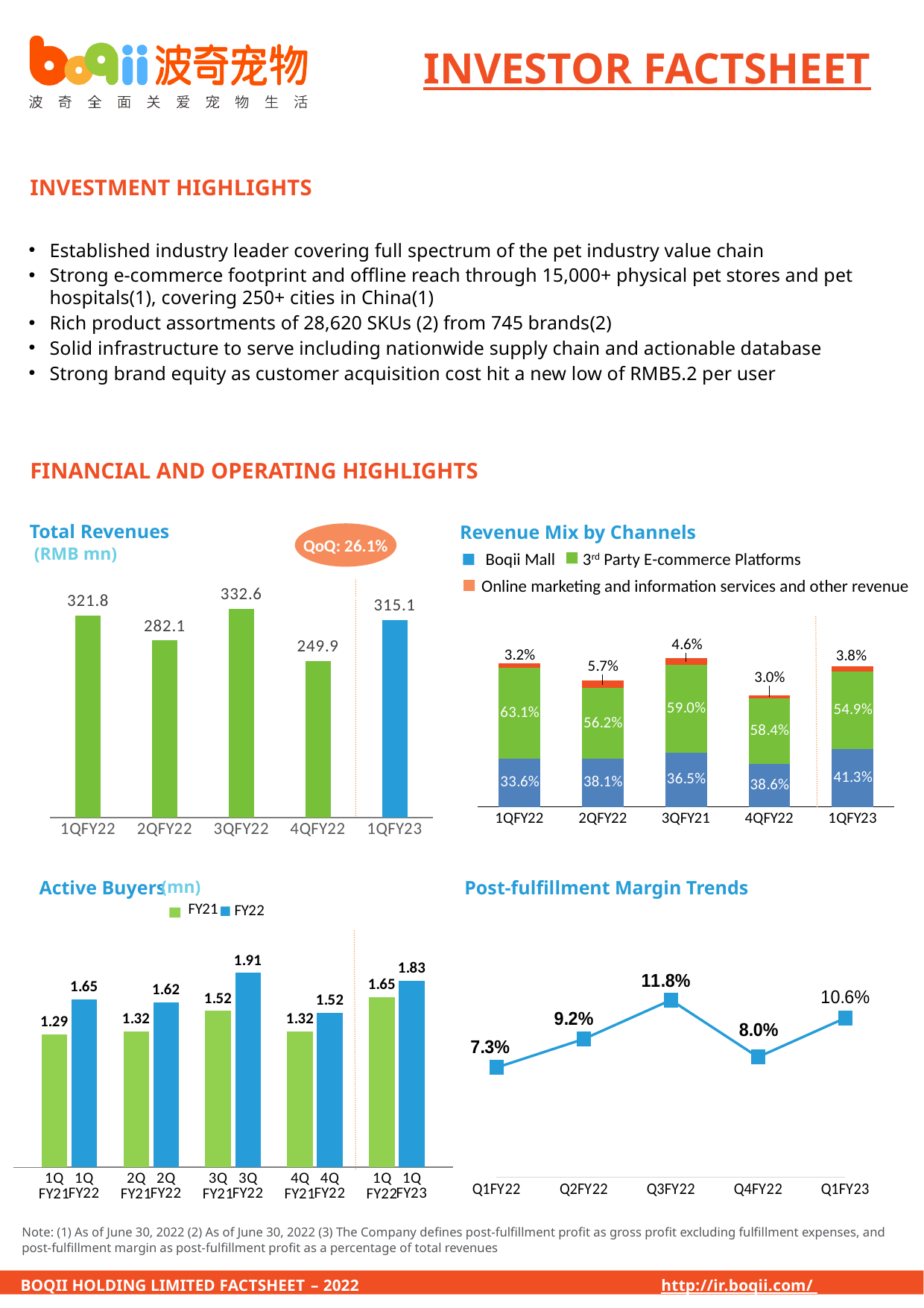
In the Total Revenues chart, which quarter has the lowest revenue? 4QFY22 How many series does the legend of the Revenue Mix by Channels chart list? 3 In the Active Buyers chart, what is the value for 3Q FY22? 1.91 In the Revenue Mix by Channels chart, what is the Boqii Mall share for 1QFY23? 41.3% In the Total Revenues chart, what is the difference between 3QFY22 and 4QFY22? 82.7 In the Total Revenues chart, what is the value for 3QFY22? 332.6 In the Post-fulfillment Margin Trends chart, which quarter has the highest margin? Q3FY22 In the Post-fulfillment Margin Trends chart, is the value for Q4FY22 larger or smaller than the value for Q1FY23? Smaller In the Active Buyers chart, what is the difference between 3Q FY22 and 3Q FY21? 0.39 How many quarters are shown in the Total Revenues chart? 5 In the Revenue Mix by Channels chart, which quarter has the highest share for Online marketing and information services and other revenue? 2QFY22 What kind of chart is the Post-fulfillment Margin Trends chart? Line chart